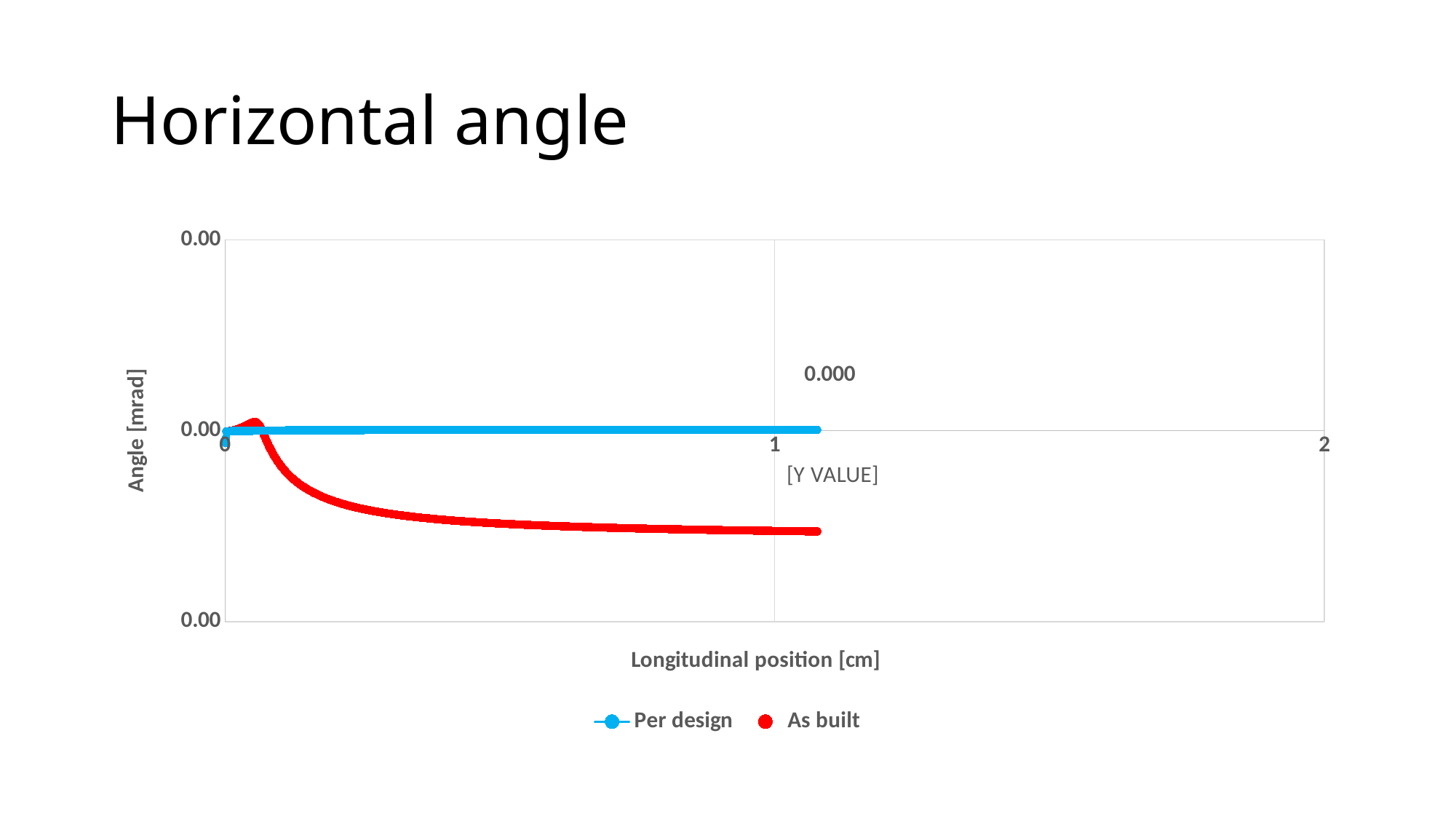
Does the As built series rise or fall as longitudinal position increases from about 0.1 cm to 1 cm? fall What is the highest value shown on the x axis? 2 Which series reaches the lowest angle value on the chart? As built How many series does the chart legend list? 2 Does the Per design series rise, fall, or stay flat along the x axis? stay flat What are the names of the two series in the legend? Per design, As built Which series is drawn in red? As built At a longitudinal position of 1 cm, which series has the larger angle value, Per design or As built? Per design What kind of chart is shown on the slide? line chart